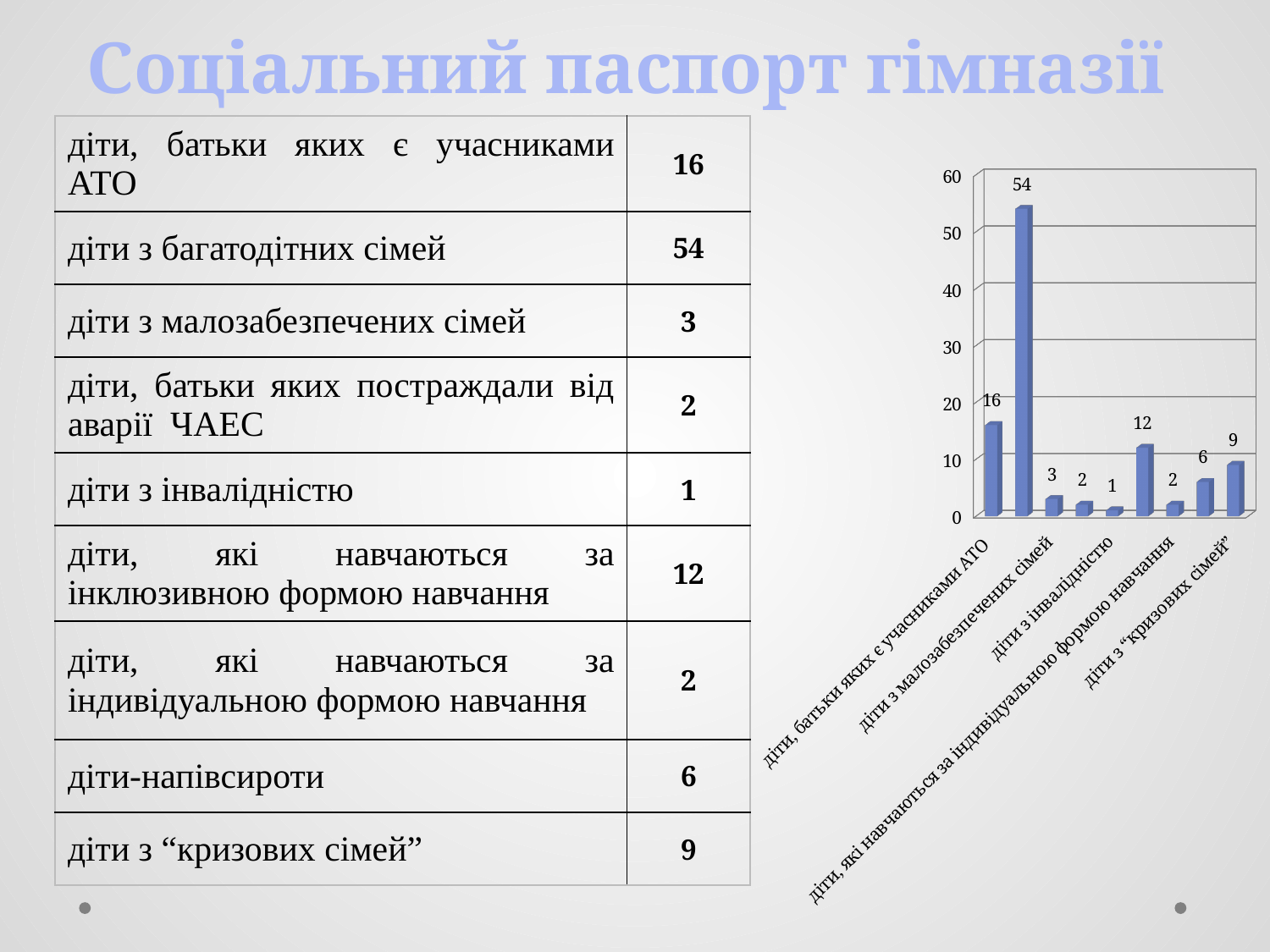
How many bars does the chart contain? 9 Which is larger: the bar for "діти з “кризових сімей”" or the bar for "діти-напівсироти"? діти з “кризових сімей” What is the value of the bar for "діти з інвалідністю"? 1 What is the difference between the bar for "діти з “кризових сімей”" and the bar for "діти з малозабезпечених сімей"? 6 What is the value of the bar for "діти з “кризових сімей”"? 9 What type of chart is shown on the slide? bar chart What is the difference between the highest bar (54) and the bar for "діти, батьки яких є учасниками АТО" (16)? 38 What is the value of the bar for "діти з малозабезпечених сімей"? 3 Which category has the lowest bar in the chart? діти з інвалідністю What is the maximum value shown on the chart's vertical axis? 60 What is the value of the bar for "діти, батьки яких є учасниками АТО"? 16 Which category has the highest bar in the chart? діти з багатодітних сімей